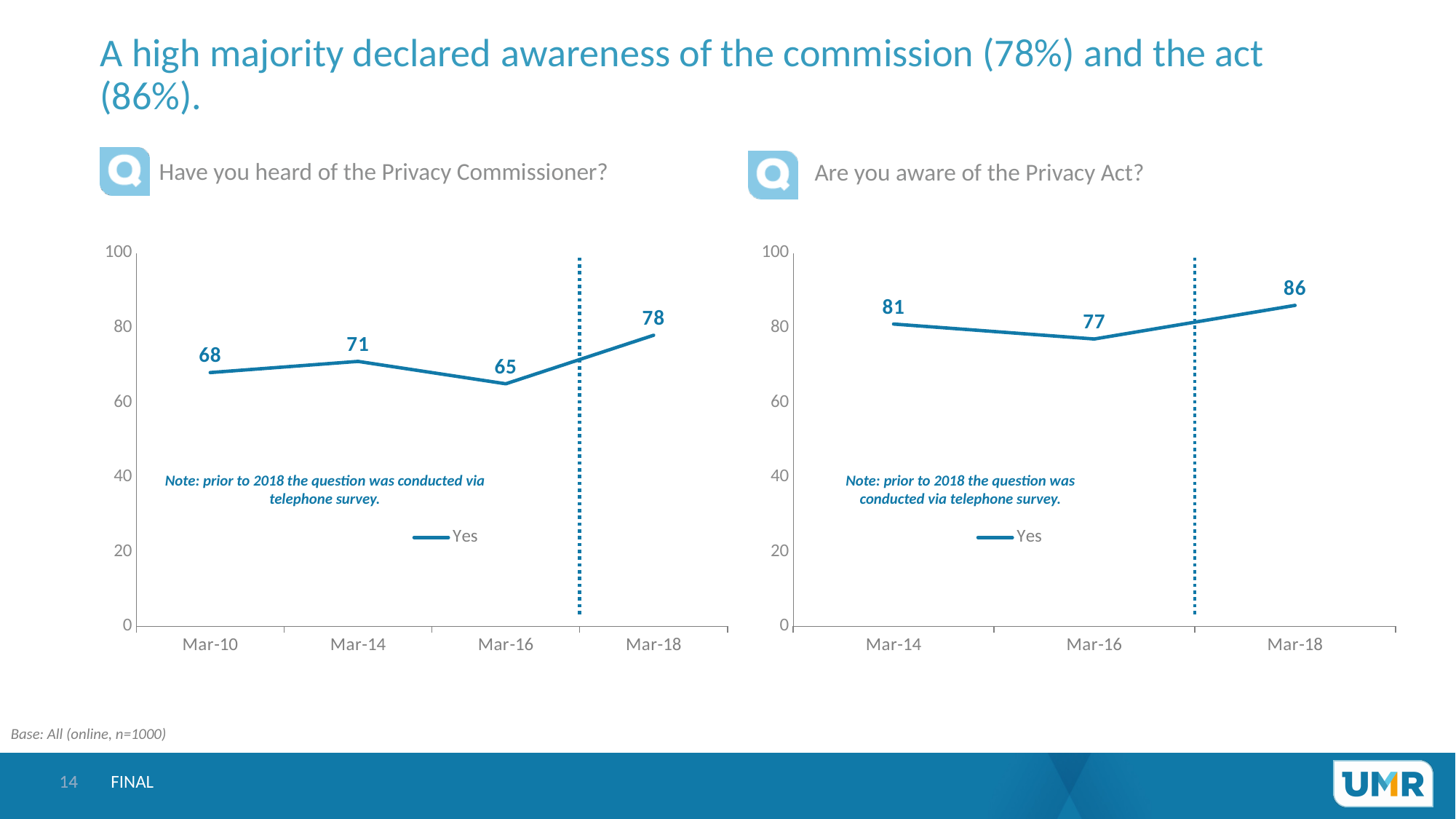
In the left chart (Have you heard of the Privacy Commissioner?), what is the difference between the Mar-18 and Mar-16 values? 13 In the right chart (Are you aware of the Privacy Act?), what is the value for Mar-16? 77 In the right chart (Are you aware of the Privacy Act?), what is the difference between the Mar-18 and Mar-14 values? 5 How many time points are plotted in the left chart (Have you heard of the Privacy Commissioner?)? 4 How many time points are plotted in the right chart (Are you aware of the Privacy Act?)? 3 How many series does the legend of the left chart (Have you heard of the Privacy Commissioner?) list? 1 What kind of chart is the right chart (Are you aware of the Privacy Act?)? Line chart In the left chart (Have you heard of the Privacy Commissioner?), which time point has the lowest value? Mar-16 In the left chart (Have you heard of the Privacy Commissioner?), what is the value for Mar-10? 68 In the right chart (Are you aware of the Privacy Act?), which time point has the highest value? Mar-18 In the left chart (Have you heard of the Privacy Commissioner?), what is the value for Mar-18? 78 In the left chart (Have you heard of the Privacy Commissioner?), which is larger, the value for Mar-14 or the value for Mar-10? Mar-14